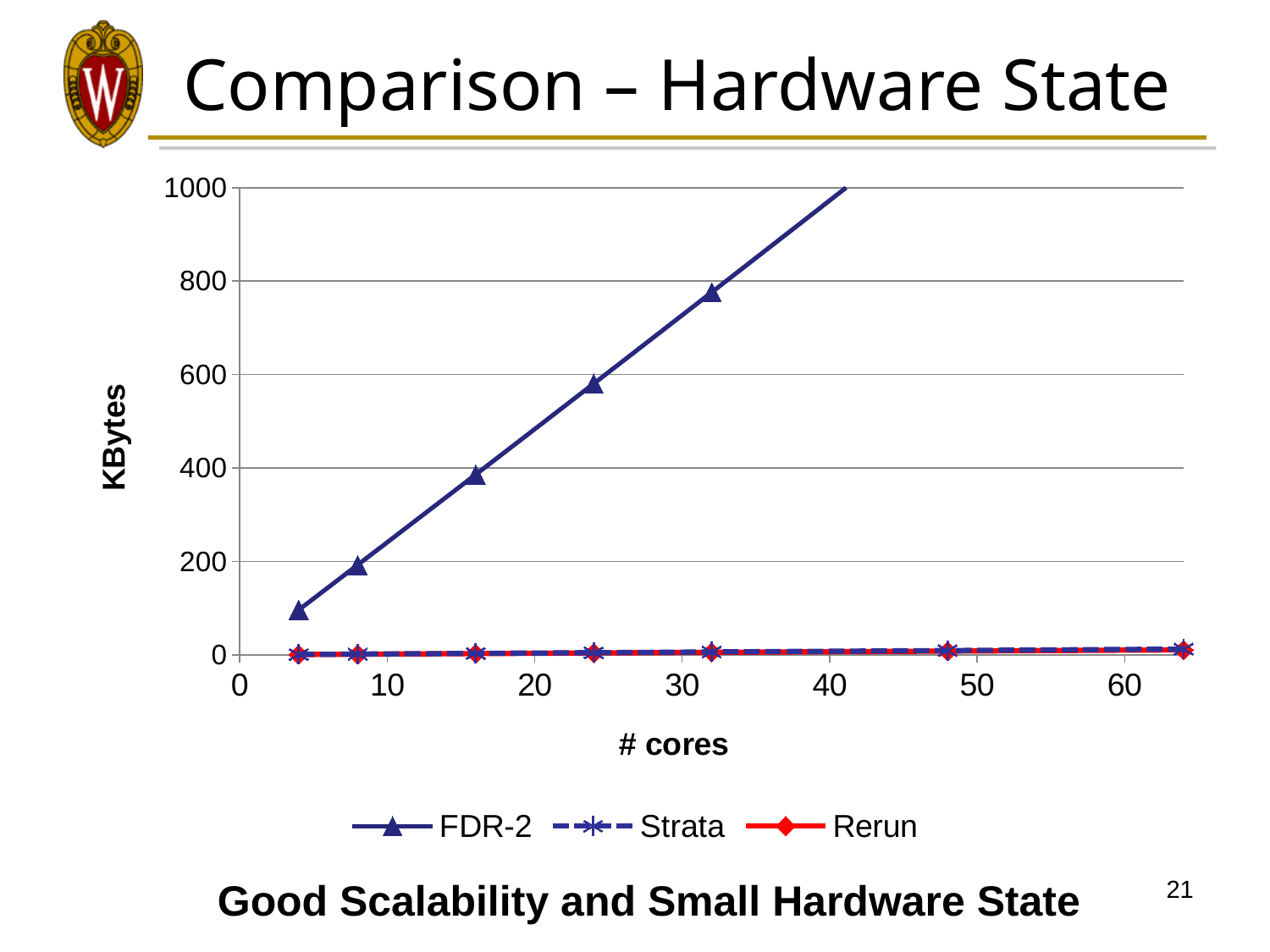
Is the FDR-2 value at 32 cores greater or less than 800? less Is the FDR-2 value at 16 cores greater or less than 200? greater What is the label of the y axis? KBytes Is the Rerun value at 64 cores greater or less than 200? less At 24 cores, which is larger: the FDR-2 value or the Rerun value? FDR-2 Which series has the highest values across the chart? FDR-2 How many series does the legend list? 3 What kind of chart is shown on the slide? line chart Does the FDR-2 series rise or fall as the number of cores increases? rise Which series are listed in the legend? FDR-2, Strata, Rerun